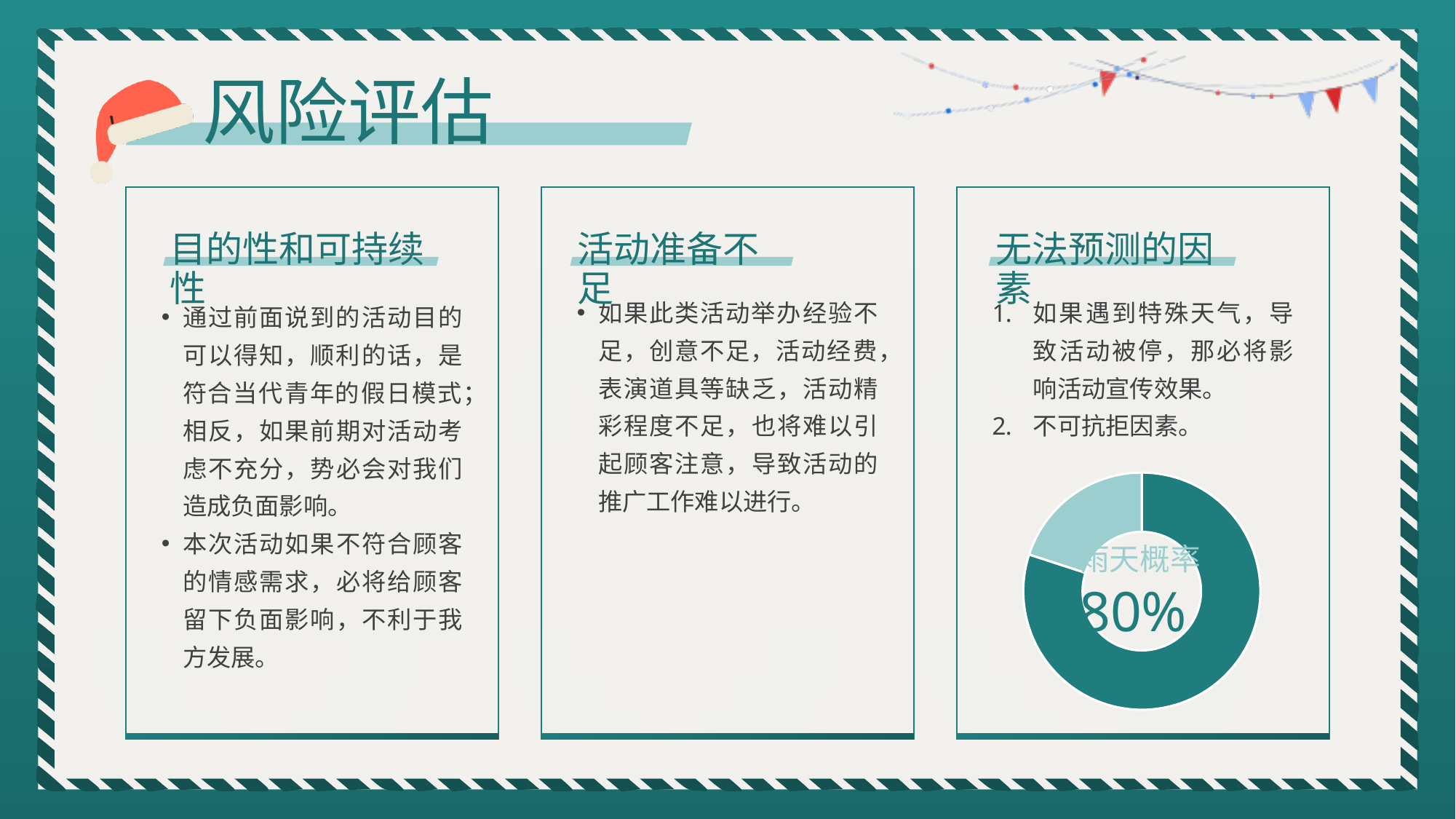
What value is printed in the centre of the doughnut chart? 80% What share of the doughnut chart does the dark teal slice represent? 80% Which colour is used for the smallest slice of the doughnut chart? light teal Which slice of the doughnut chart is larger, the dark teal one or the light teal one? the dark teal one How many slices does the doughnut chart have? 2 What kind of chart is shown in the 无法预测的因素 panel? doughnut chart Which colour is used for the largest slice of the doughnut chart? dark teal What label is printed in the centre of the doughnut chart above the percentage? 雨天概率 Under which panel heading does the doughnut chart appear? 无法预测的因素